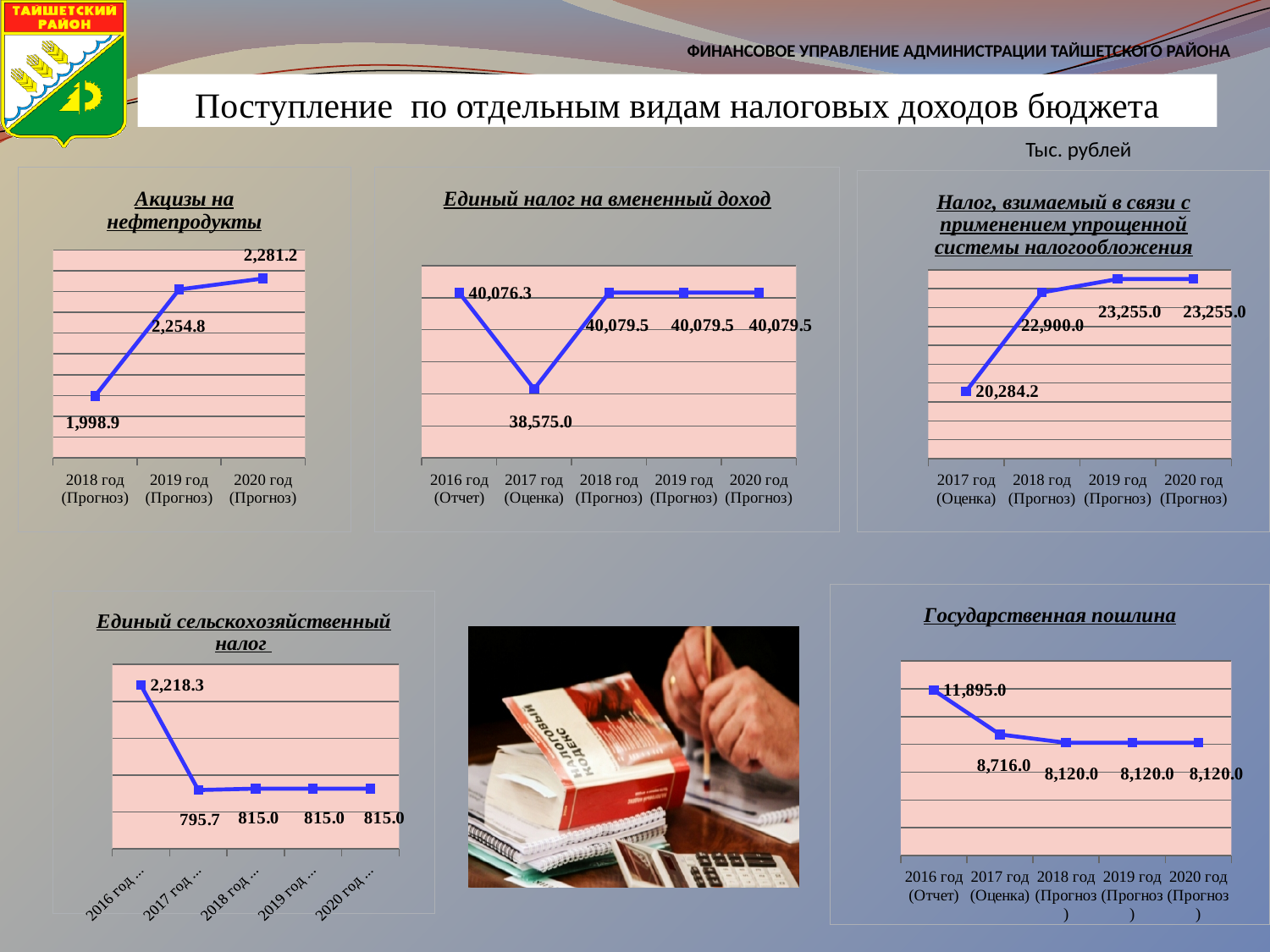
In the chart titled "Акцизы на нефтепродукты", which year has the lowest value? 2018 год (Прогноз) In the chart titled "Акцизы на нефтепродукты", what is the value for 2020 год (Прогноз)? 2,281.2 In the chart titled "Налог, взимаемый в связи с применением упрощенной системы налогообложения", what is the value for 2017 год (Оценка)? 20,284.2 In the chart titled "Налог, взимаемый в связи с применением упрощенной системы налогообложения", what is the difference between the 2018 год (Прогноз) value and the 2017 год (Оценка) value? 2,615.8 In the chart titled "Единый сельскохозяйственный налог", do the values generally rise or fall from 2016 to 2020? fall In the chart titled "Государственная пошлина", what is the value for 2017 год (Оценка)? 8,716.0 What type of chart is used for "Государственная пошлина"? line chart In the chart titled "Государственная пошлина", which is larger: the value for 2016 год (Отчет) or the value for 2018 год (Прогноз)? 2016 год (Отчет) In the chart titled "Единый налог на вмененный доход", which year has the lowest value? 2017 год (Оценка) In the chart titled "Единый налог на вмененный доход", what is the value for 2017 год (Оценка)? 38,575.0 In the chart titled "Единый сельскохозяйственный налог", what is the value for the first point (2016 год)? 2,218.3 In the chart titled "Единый налог на вмененный доход", how many data points are plotted? 5